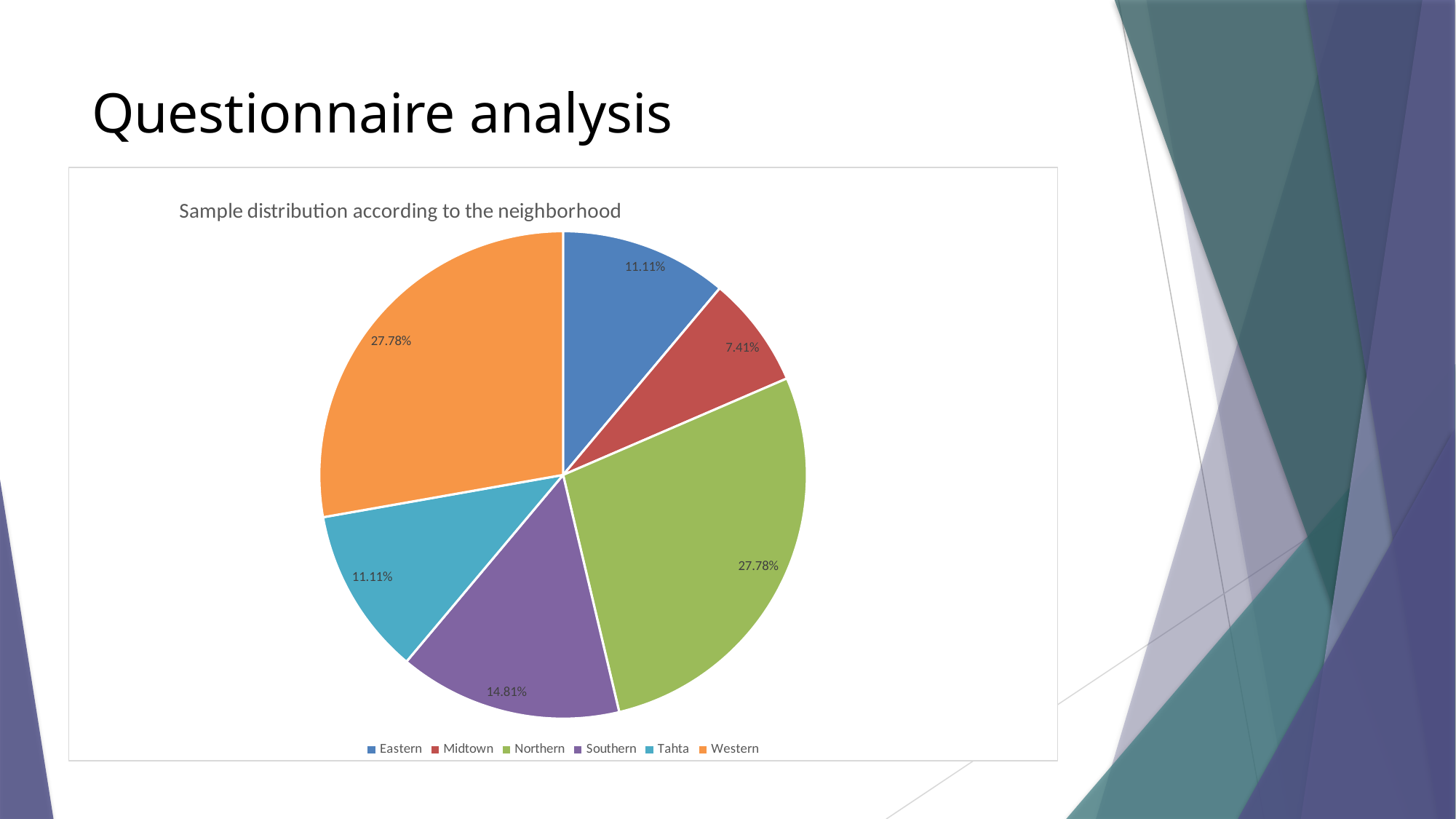
What share of the pie does Northern have? 27.78% How many neighborhoods are shown in the pie chart? 6 What share of the pie does Western have? 27.78% What is the difference between the Eastern and Midtown shares? 3.70% What share of the pie does Midtown have? 7.41% What is the difference between the Northern and Southern shares? 12.97% What kind of chart is shown on the slide? Pie chart Which is larger, the Southern slice or the Tahta slice? Southern What is the title of the chart? Sample distribution according to the neighborhood Which neighborhood has the smallest slice of the pie? Midtown What share of the pie does Tahta have? 11.11% What share of the pie does Southern have? 14.81%